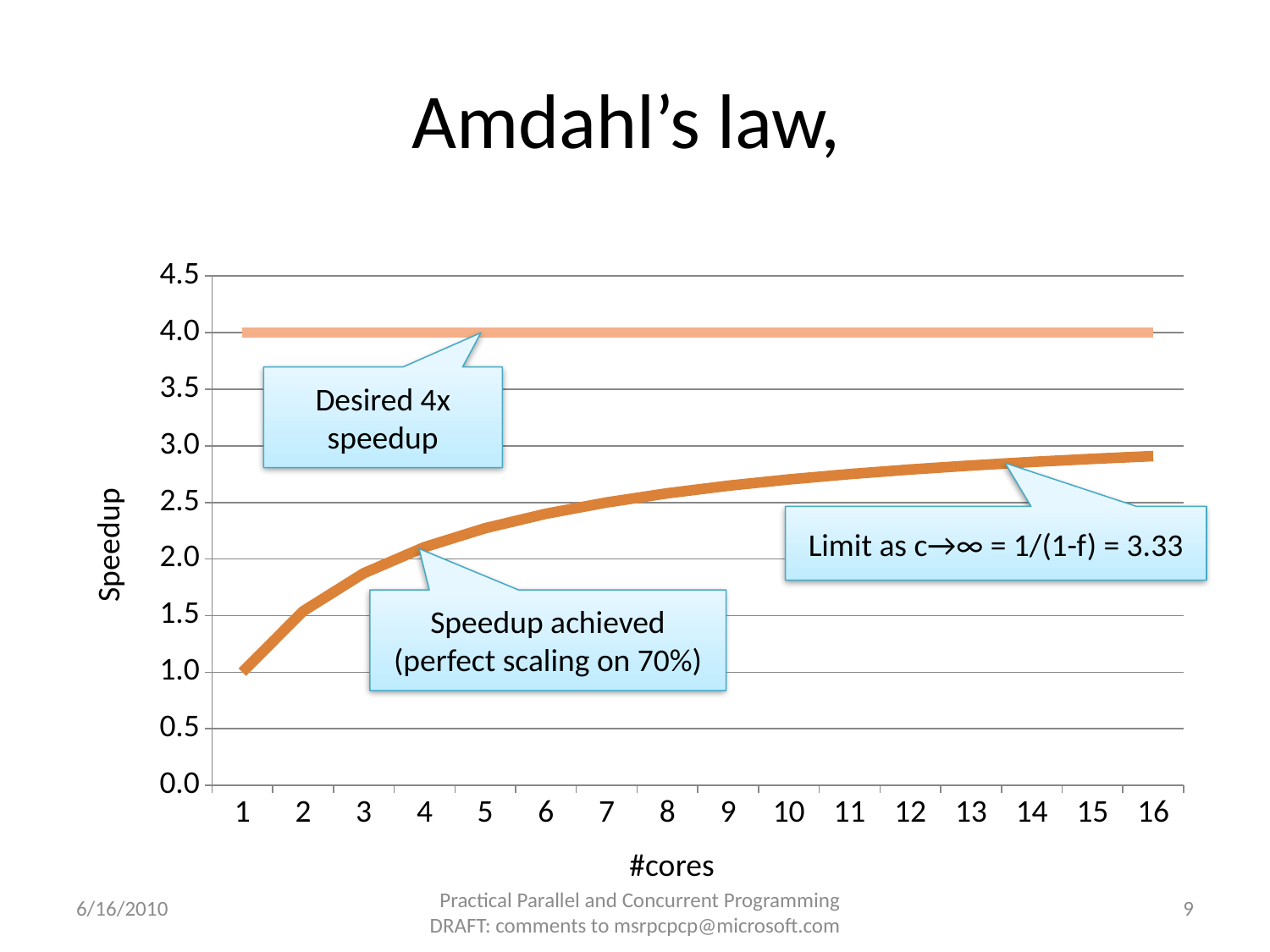
At 16 cores, which is higher: the desired speedup line or the speedup achieved curve? Desired 4x speedup How many #cores values are shown along the x axis? 16 What kind of chart is shown on the slide? line chart Is the speedup achieved at 16 cores greater or less than 3.0? less Is the speedup achieved at 8 cores greater or less than 2.5? greater According to the callout, what is the limit of the speedup as c→∞? 3.33 What is the speedup achieved at 1 core? 1.0 What is the label of the x axis? #cores Is the speedup achieved at 2 cores greater or less than 2.0? less At which number of cores is the speedup achieved lowest? 1 Does the speedup achieved rise or fall as the number of cores increases? rises What is the value of the 'Desired 4x speedup' line? 4.0